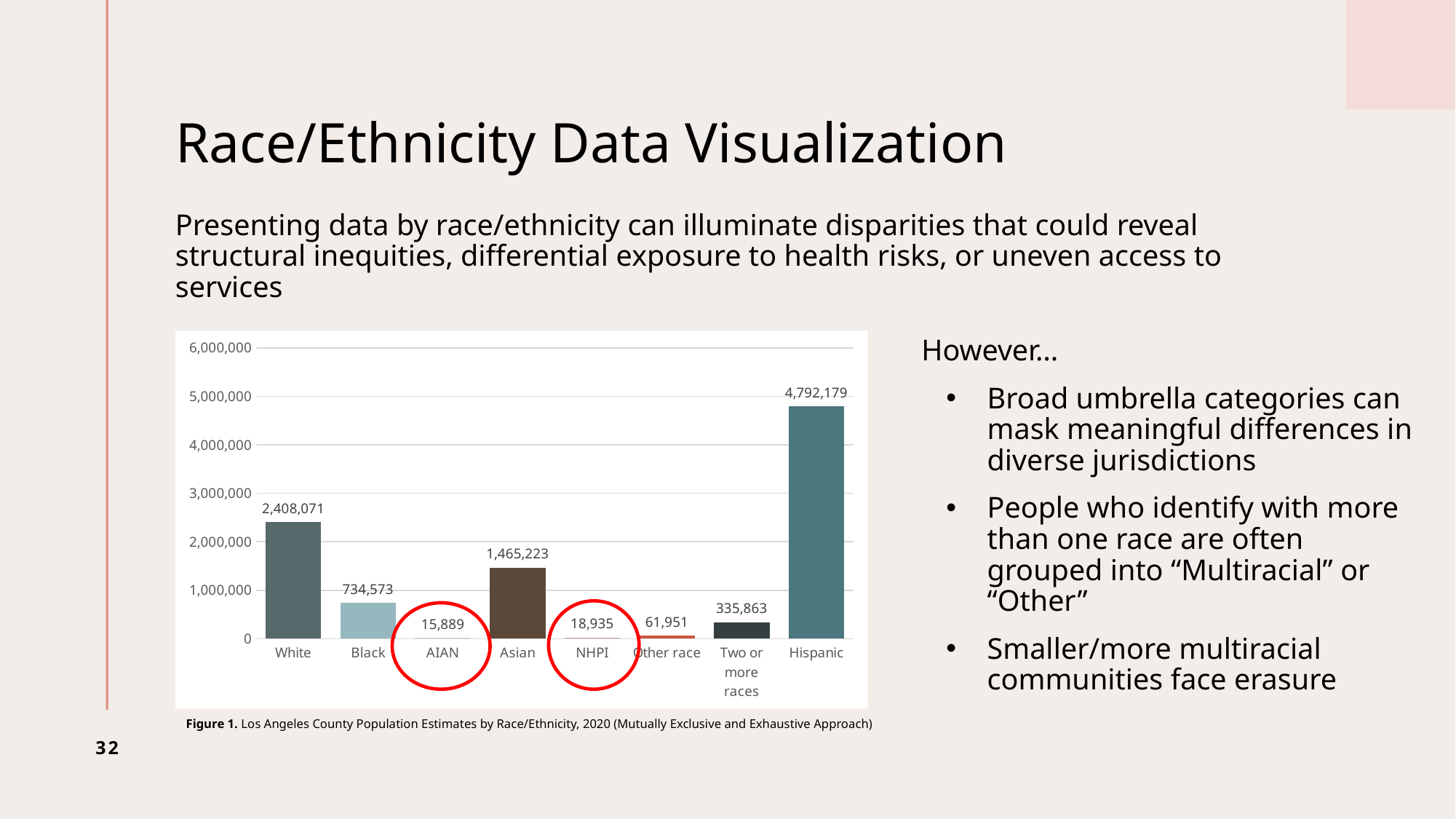
What kind of chart is shown on the slide? bar chart What is the difference between the NHPI and AIAN values? 3,046 What is the population estimate for White in the chart? 2,408,071 What is the value shown for NHPI? 18,935 How many race/ethnicity categories are shown on the x axis? 8 What is the difference between the Hispanic and White values? 2,384,108 Which category has the lowest population estimate? AIAN Which category has the highest population estimate? Hispanic Which is larger, the value for Black or the value for Asian? Asian Is the value for Two or more races greater or less than 1,000,000? less What is the population estimate for Hispanic in the chart? 4,792,179 What is the value shown for AIAN? 15,889